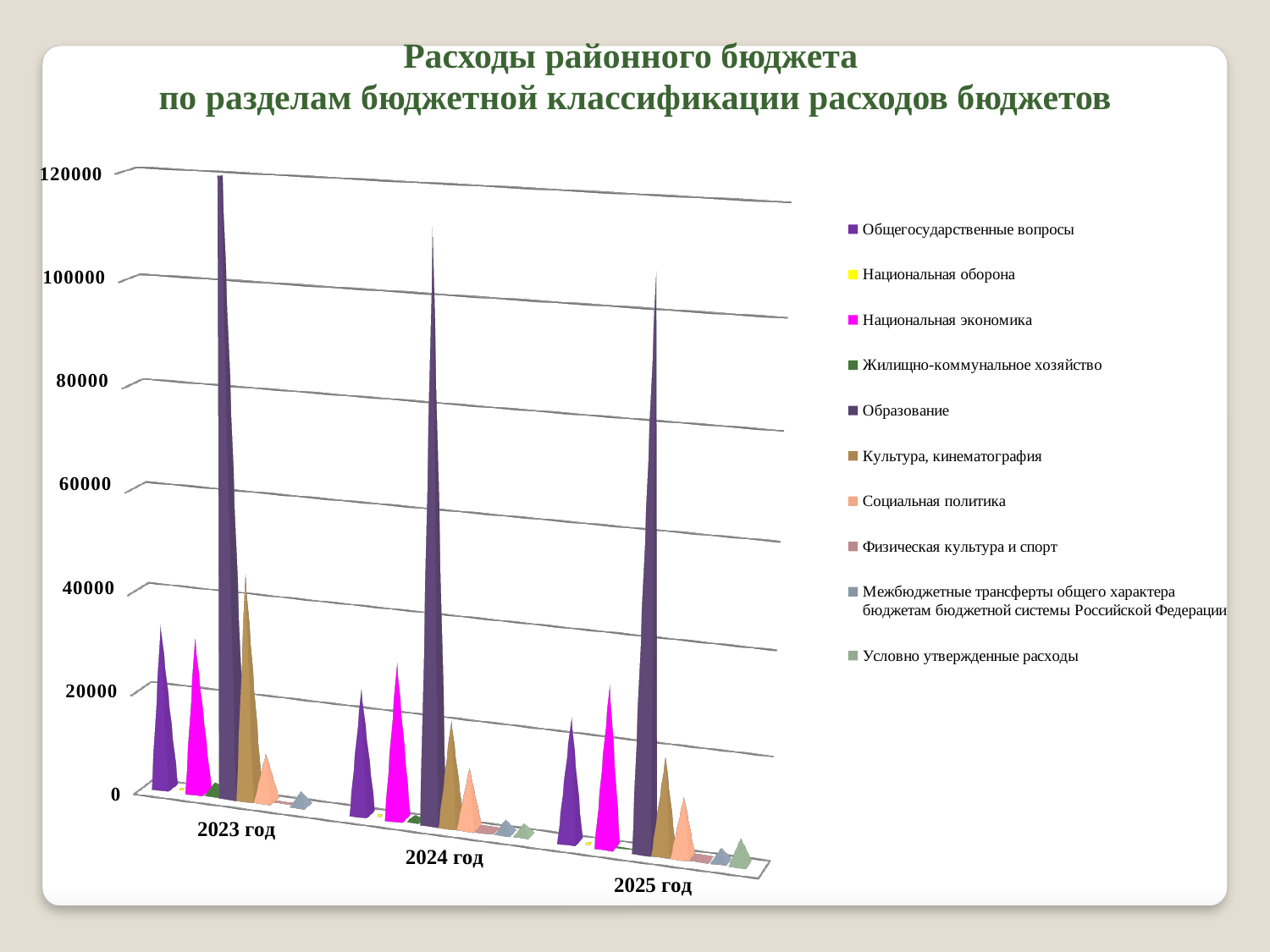
What is the first series listed in the legend? Общегосударственные вопросы How many series does the legend list? 10 Which is larger in 2023 год: Культура, кинематография or Социальная политика? Культура, кинематография Which series has the highest value in 2023 год? Образование Is the value for Образование in 2024 год greater or less than 80000? greater In which year is the value for Образование the highest? 2023 год Does the value for Образование rise or fall from 2023 год to 2025 год? fall Is the value for Социальная политика in 2025 год greater or less than 20000? less What kind of chart is shown on the slide? bar chart Is the value for Национальная экономика in 2023 год greater or less than 40000? less How many year categories are shown on the x axis? 3